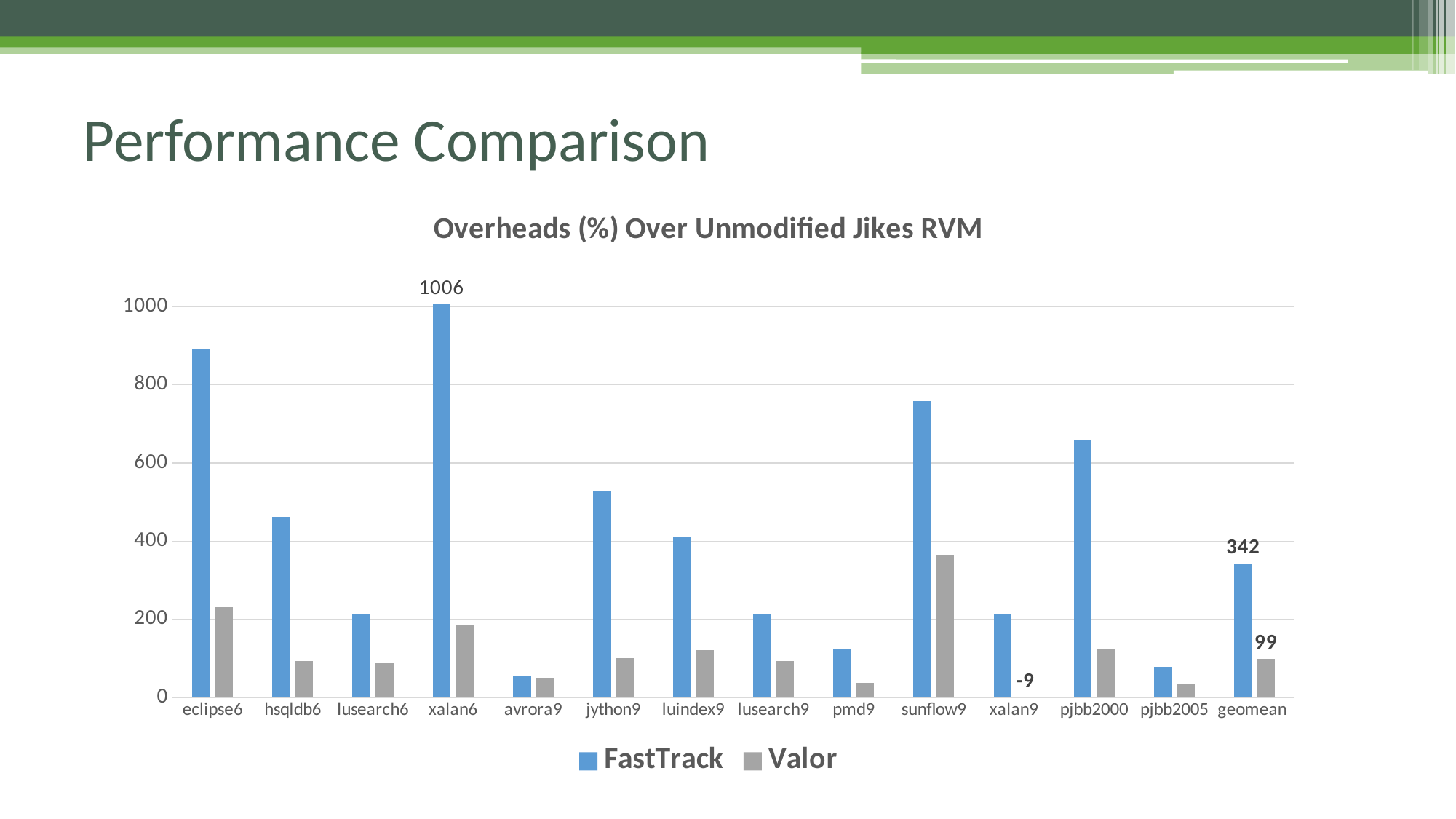
What is the Valor value for geomean? 99 What is the FastTrack value for geomean? 342 How many categories are shown on the x axis? 14 What is the title of the chart? Overheads (%) Over Unmodified Jikes RVM What is the Valor value for xalan9? -9 Which category has the highest Valor value? sunflow9 What type of chart is shown on the slide? bar chart What is the difference between the FastTrack and Valor values for geomean? 243 How many series does the legend list? 2 Which category has the highest FastTrack value? xalan6 What is the FastTrack value for xalan6? 1006 Is the FastTrack value for eclipse6 greater or less than 800? greater